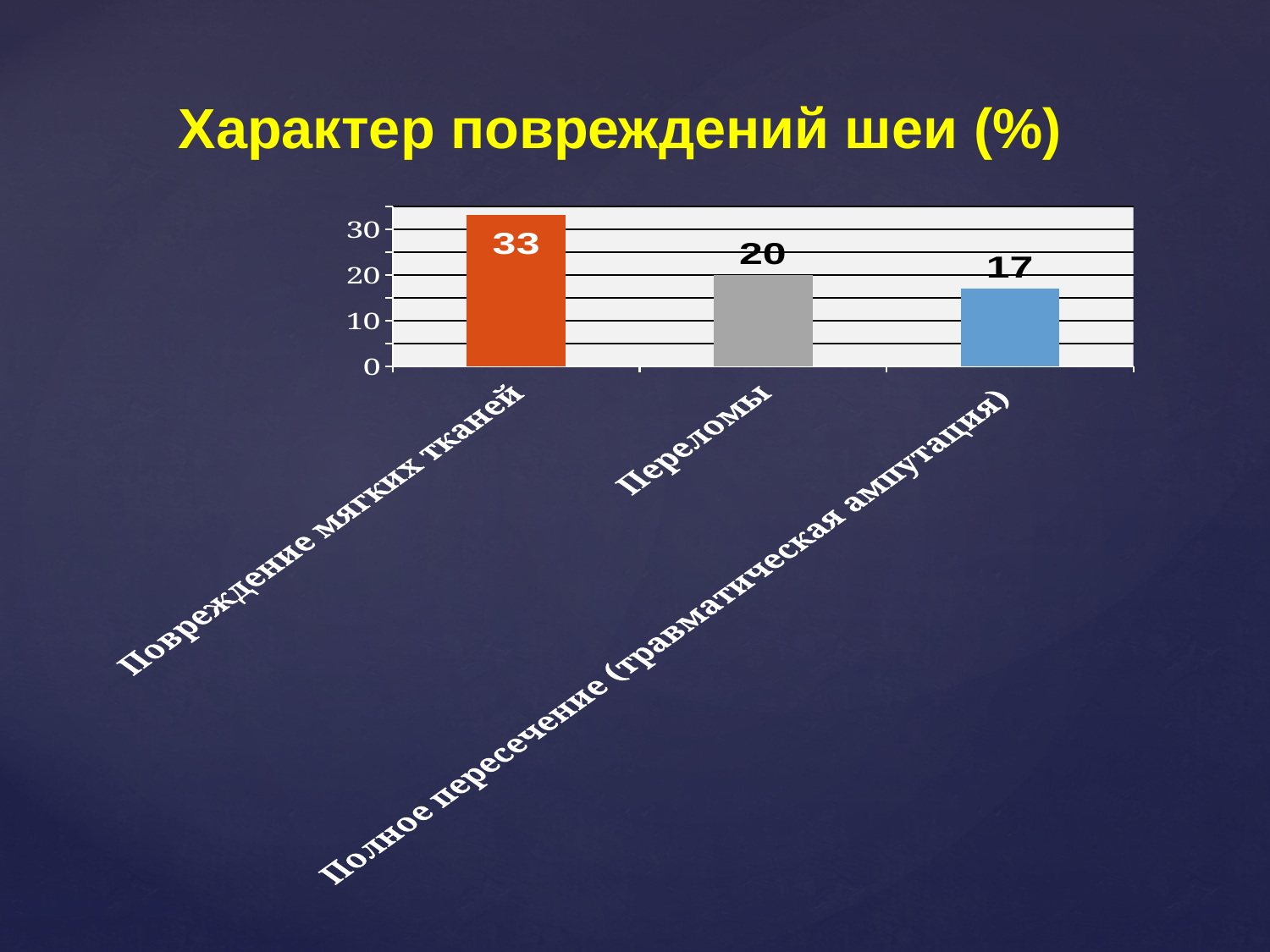
Which category has the lowest value? Полное пересечение (травматическая ампутация) How many categories are shown in the chart? 3 What is the difference between the values for Переломы and Полное пересечение (травматическая ампутация)? 3 What is the value for Полное пересечение (травматическая ампутация)? 17 What kind of chart is shown on the slide? bar chart What is the value for Переломы? 20 Is the value for Повреждение мягких тканей greater or less than 30? greater Which is larger, the value for Переломы or the value for Полное пересечение (травматическая ампутация)? Переломы What is the difference between the values for Повреждение мягких тканей and Переломы? 13 What is the title of the slide? Характер повреждений шеи (%) Which category has the highest value? Повреждение мягких тканей What is the value for Повреждение мягких тканей? 33